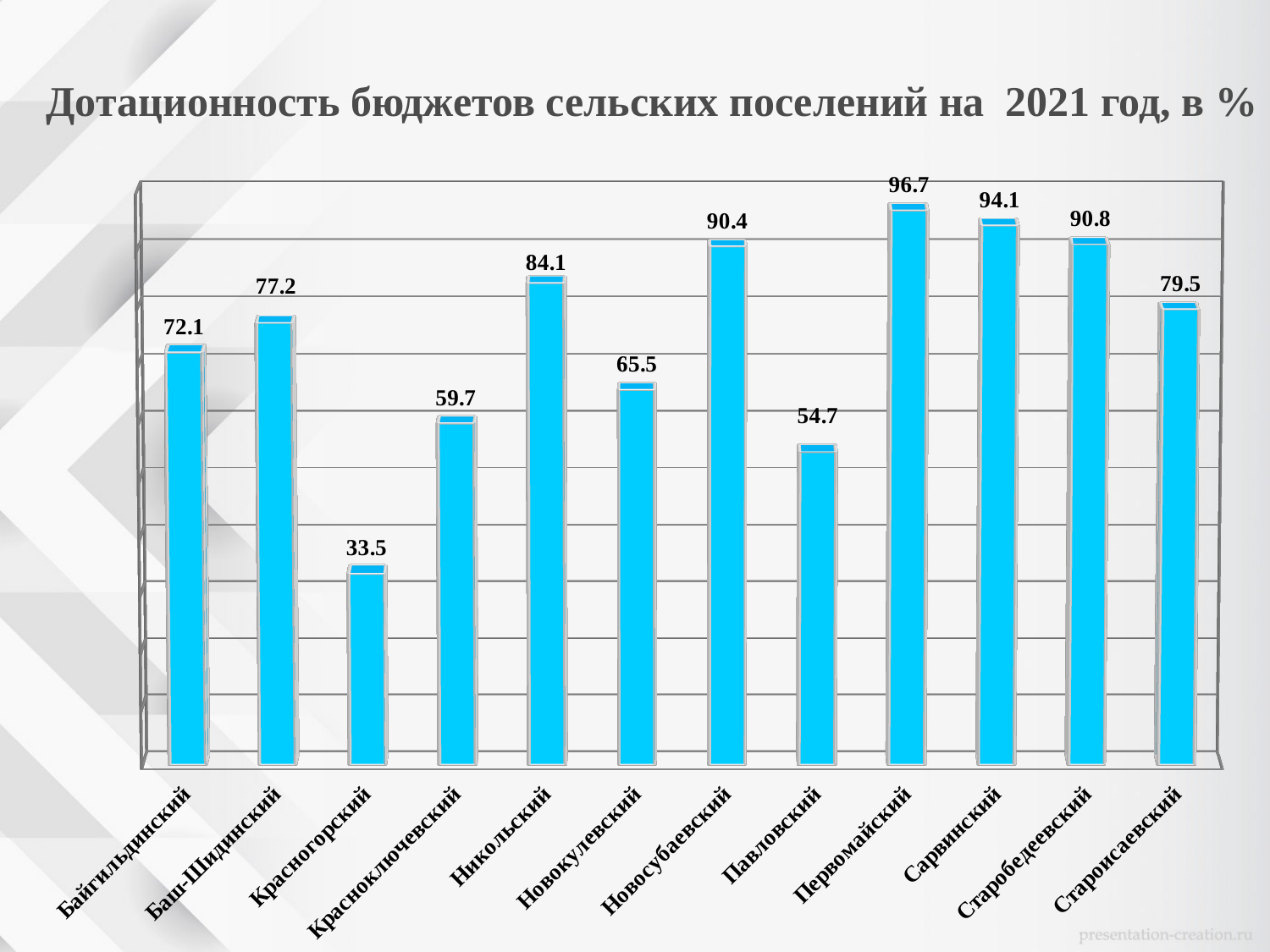
What is the difference between the values for Баш-Шидинский and Байгильдинский? 5.1 How many settlements are shown in the chart? 12 Which is larger, the value for Никольский or the value for Староисаевский? Никольский What is the title of the chart? Дотационность бюджетов сельских поселений на 2021 год, в % What is the value for Первомайский? 96.7 Which is larger, the value for Красноключевский or the value for Павловский? Красноключевский What is the difference between the values for Сарвинский and Павловский? 39.4 Which settlement has the highest value? Первомайский What is the value for Новокулевский? 65.5 What kind of chart is shown on the slide? Bar chart What is the value for Красногорский? 33.5 Which settlement has the lowest value? Красногорский